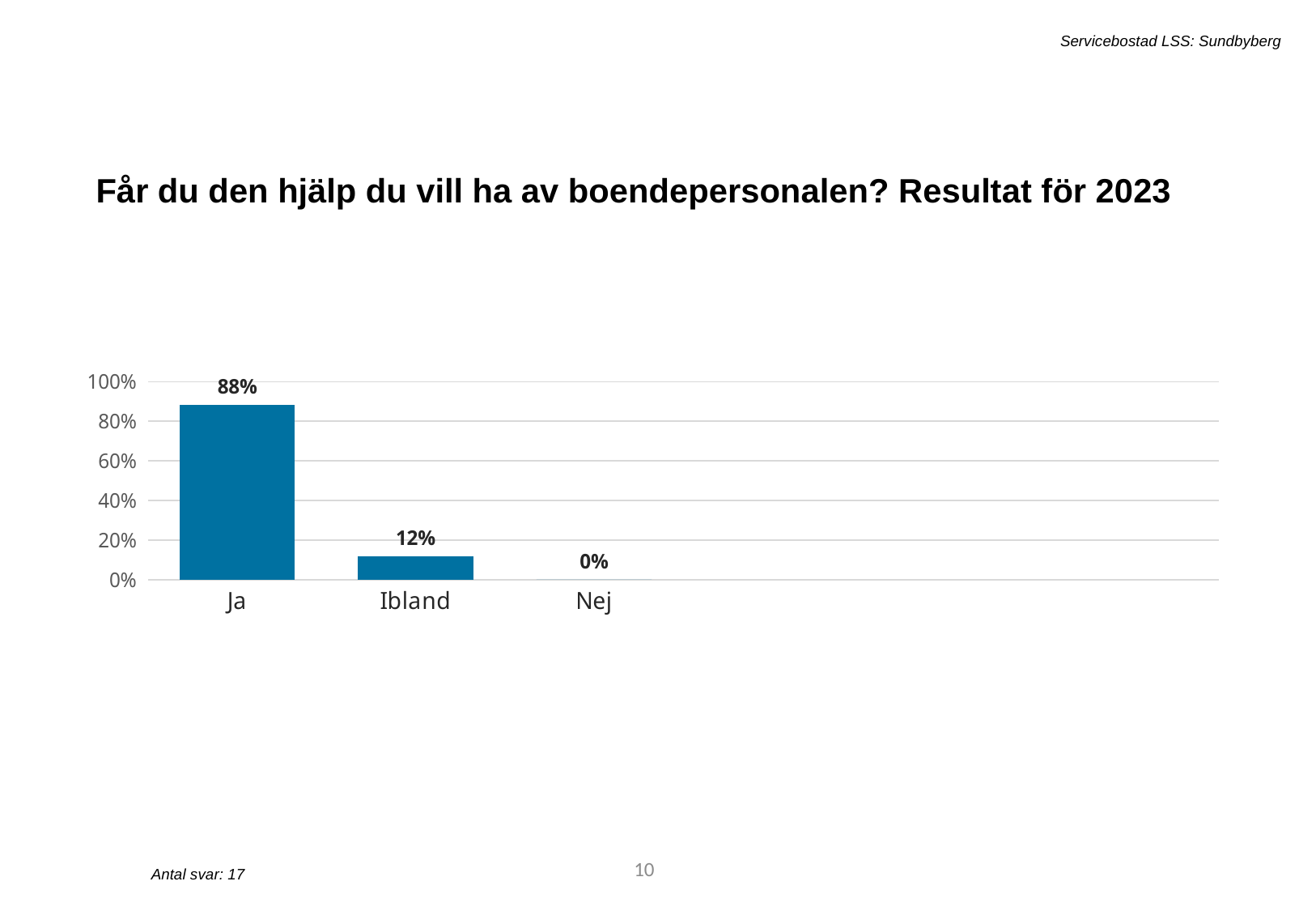
Which category has the highest value? Ja What is the difference between the values for Ja and Ibland? 76% What is the value for Ibland? 12% Is the value for Ja greater or less than 80%? greater What is the value for Ja? 88% Which category has the lowest value? Nej Do the values rise or fall from left to right along the x axis? fall What kind of chart is shown on the slide? bar chart What is the value for Nej? 0% What is the title of the chart? Får du den hjälp du vill ha av boendepersonalen? Resultat för 2023 Which is larger, the value for Ibland or the value for Nej? Ibland How many categories are shown on the x axis? 3